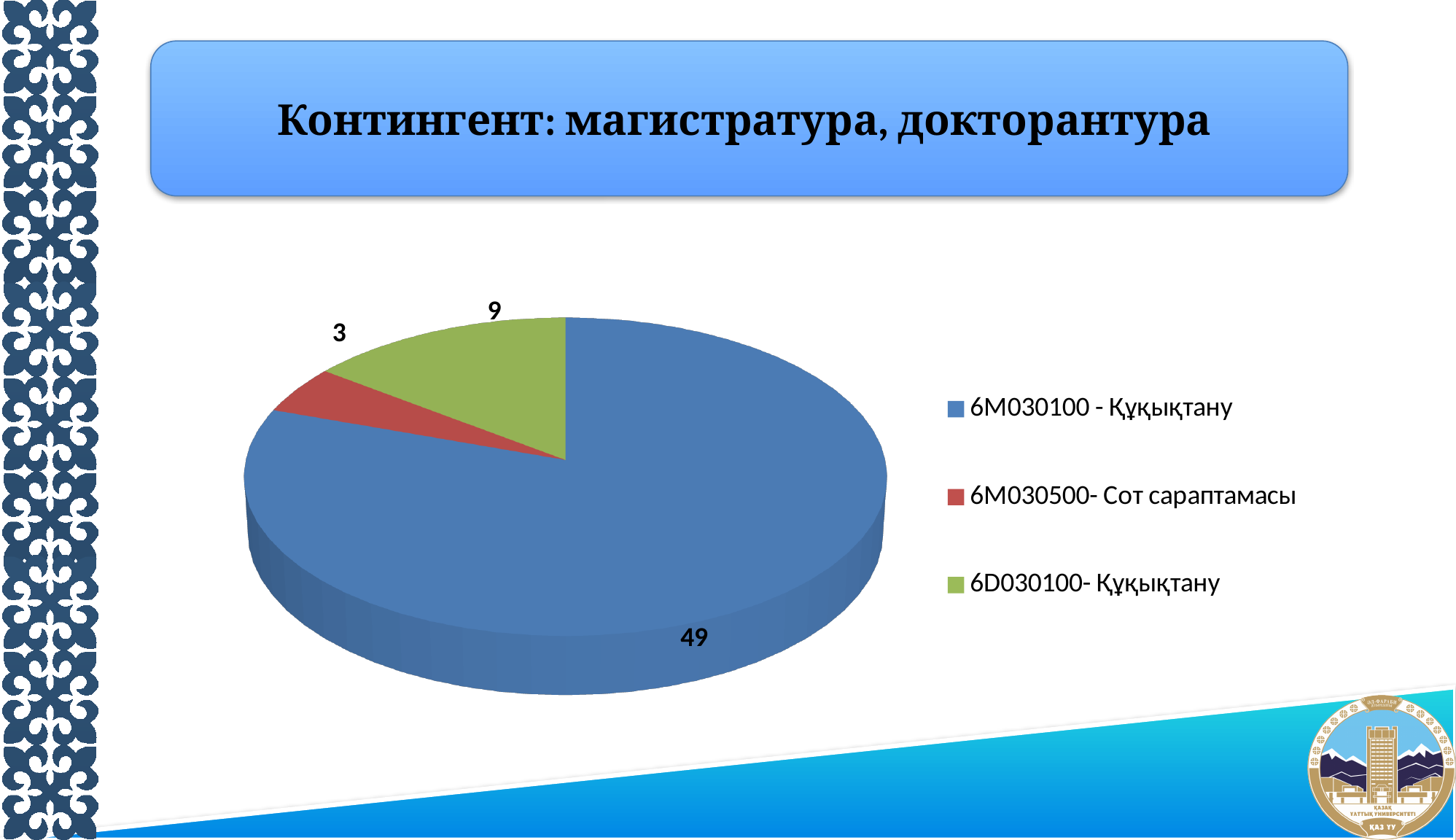
What is the value for 6M030100 - Құқықтану? 49 What is the value for 6M030500- Сот сараптамасы? 3 What is the difference between the values for 6D030100- Құқықтану and 6M030500- Сот сараптамасы? 6 Which category has the smallest slice of the pie? 6M030500- Сот сараптамасы What is the value for 6D030100- Құқықтану? 9 How many slices does the pie chart have? 3 What kind of chart is shown on the slide? pie chart What is the difference between the values for 6M030100 - Құқықтану and 6D030100- Құқықтану? 40 Which category has the largest slice of the pie? 6M030100 - Құқықтану What is the title of the slide containing the chart? Контингент: магистратура, докторантура Which is larger, the value for 6D030100- Құқықтану or the value for 6M030500- Сот сараптамасы? 6D030100- Құқықтану What is the total of all the values shown in the pie chart? 61